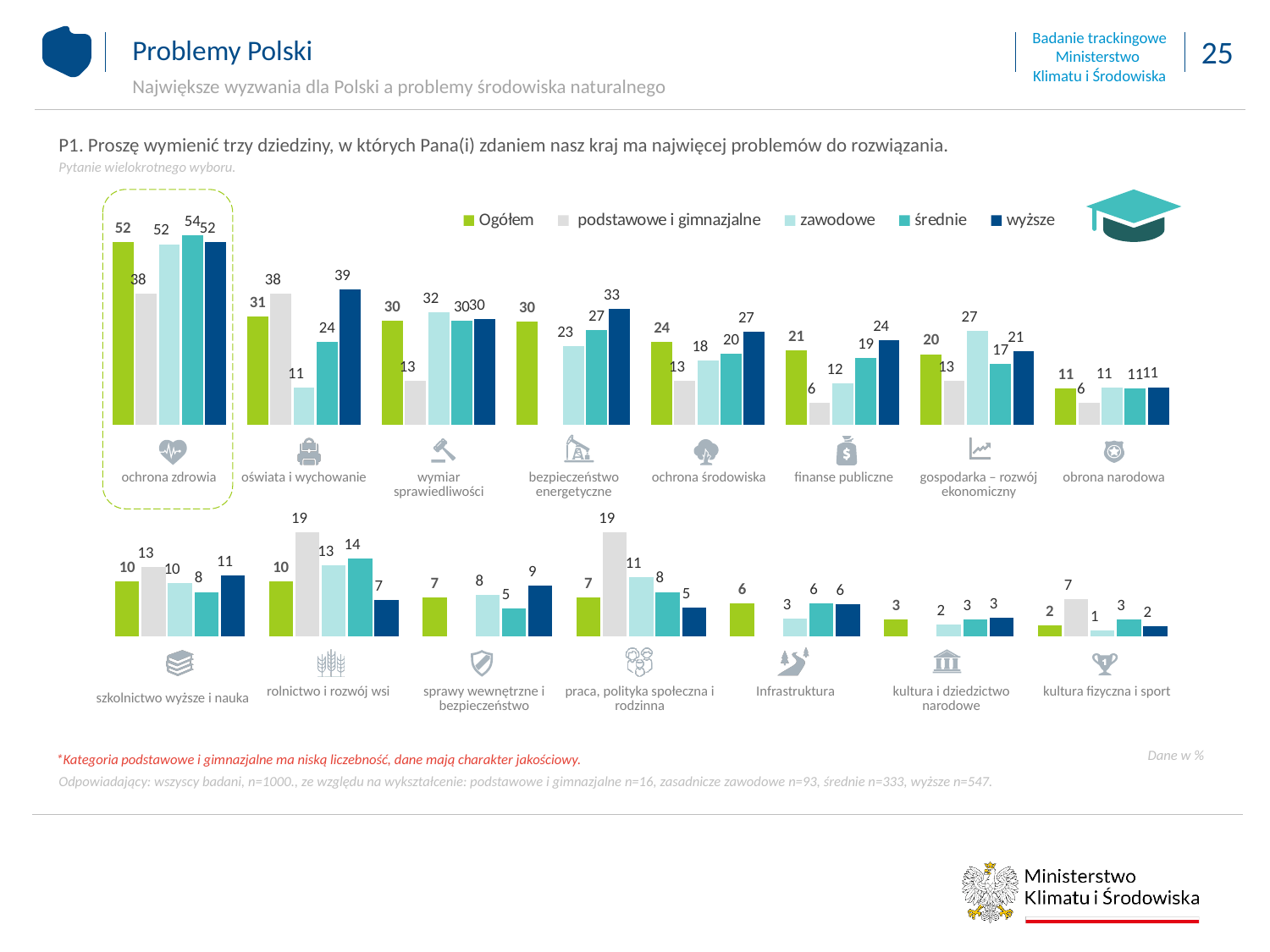
Which category has the highest Ogółem value? ochrona zdrowia What is the podstawowe i gimnazjalne value for rolnictwo i rozwój wsi? 19 What is the difference between the wyższe and podstawowe i gimnazjalne values for finanse publiczne? 18 How many categories are shown across the chart? 15 What is the Ogółem value for ochrona zdrowia? 52 What is the zawodowe value for gospodarka – rozwój ekonomiczny? 27 Which series is shown in light grey in the legend? podstawowe i gimnazjalne What kind of chart is shown on the slide? bar chart How many series does the legend list? 5 What is the wyższe value for oświata i wychowanie? 39 For ochrona środowiska, which is larger: the wyższe value or the zawodowe value? wyższe Which category has the lowest Ogółem value? kultura fizyczna i sport